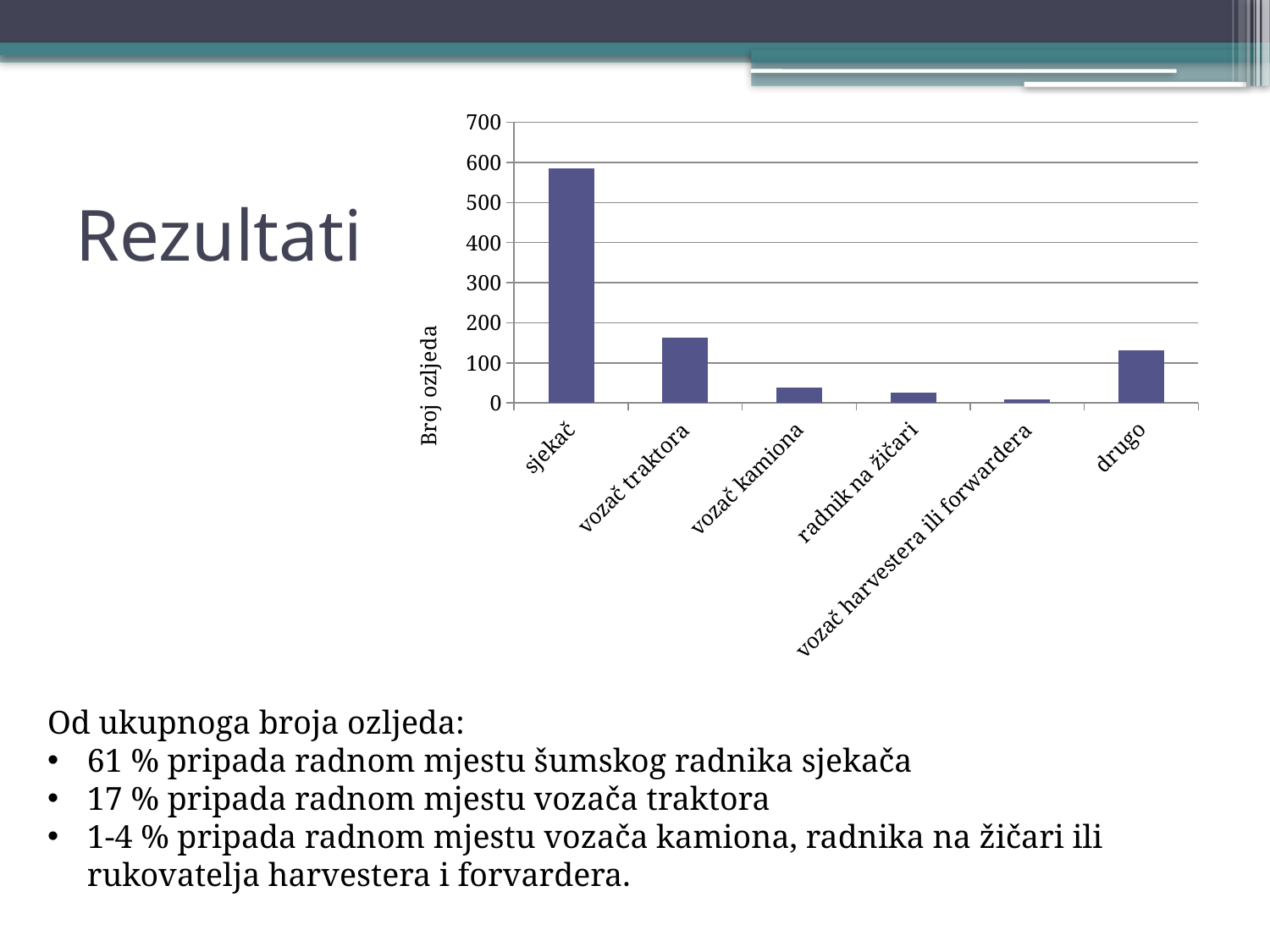
Is the value for vozač traktora greater or less than 200? less Is the value for vozač kamiona greater or less than 100? less Which category has the lowest number of injuries in the chart? vozač harvestera ili forwardera Is the value for vozač traktora greater or less than 100? greater Which has more injuries, vozač traktora or drugo? vozač traktora How many categories are shown on the x axis of the chart? 6 What is the label of the vertical axis of the chart? Broj ozljeda What kind of chart is shown on the slide? bar chart Which has more injuries, sjekač or vozač traktora? sjekač Which category has the highest number of injuries in the chart? sjekač